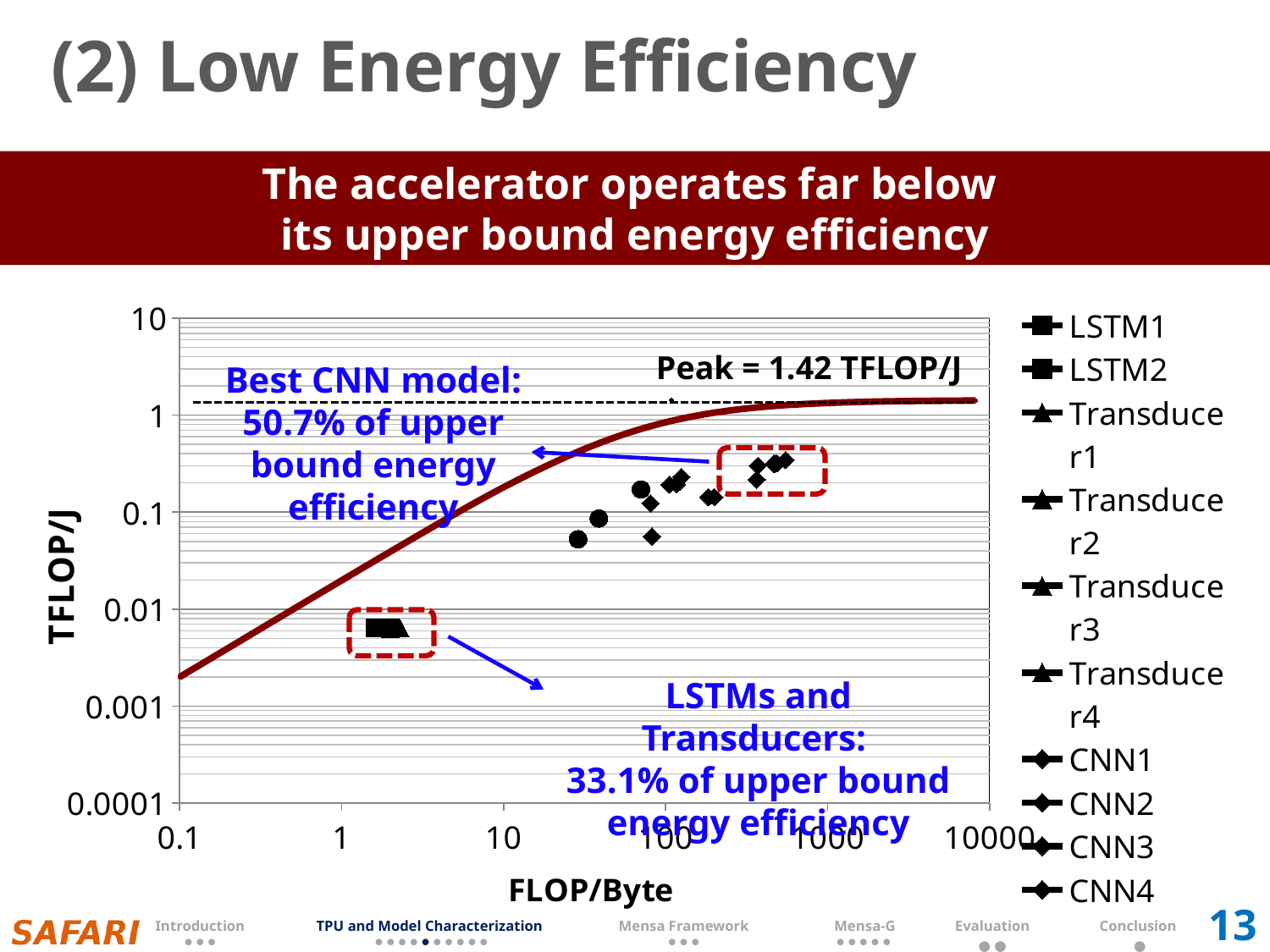
What is the label of the x axis? FLOP/Byte Are the TFLOP/J values for the CNN points greater or less than 1? less What is the peak energy efficiency value annotated on the chart? 1.42 TFLOP/J According to the annotation, what percentage of the upper bound energy efficiency do the LSTMs and Transducers reach? 33.1% Are the TFLOP/J values for the LSTM and Transducer points greater or less than 0.01? less By how many percentage points does the best CNN model's share of upper bound energy efficiency exceed that of the LSTMs and Transducers? 17.6 What kind of chart is shown on the slide? scatter chart What is the label of the y axis? TFLOP/J How many series does the legend list? 10 Which group of points has higher TFLOP/J values, the CNN points or the LSTM/Transducer points? CNN points According to the annotation, what percentage of the upper bound energy efficiency does the best CNN model reach? 50.7% Does the red upper bound curve rise or fall as FLOP/Byte increases? rise